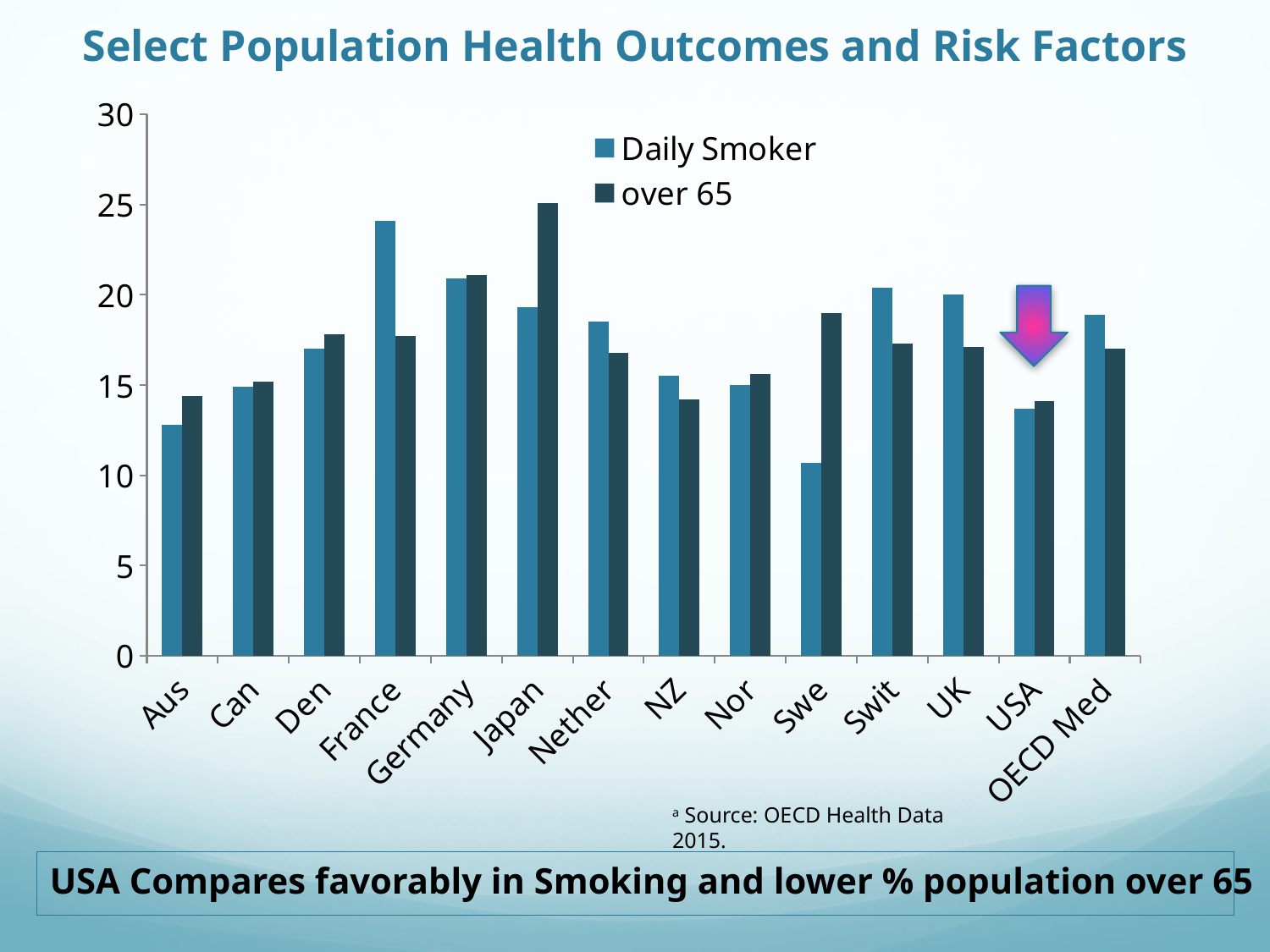
What are the two series named in the legend? Daily Smoker and over 65 Is the over 65 value for Japan greater or less than 20? greater Which category has the highest Daily Smoker value? France What kind of chart is shown on the slide? bar chart Which category has the highest over 65 value? Japan For France, which is larger: the Daily Smoker value or the over 65 value? Daily Smoker Which category has the lowest Daily Smoker value? Swe Is the Daily Smoker value for Aus greater or less than 15? less For Swe, which is larger: the Daily Smoker value or the over 65 value? over 65 How many series does the legend list? 2 Is the Daily Smoker value for France greater or less than 20? greater How many countries/categories are shown on the x axis? 14